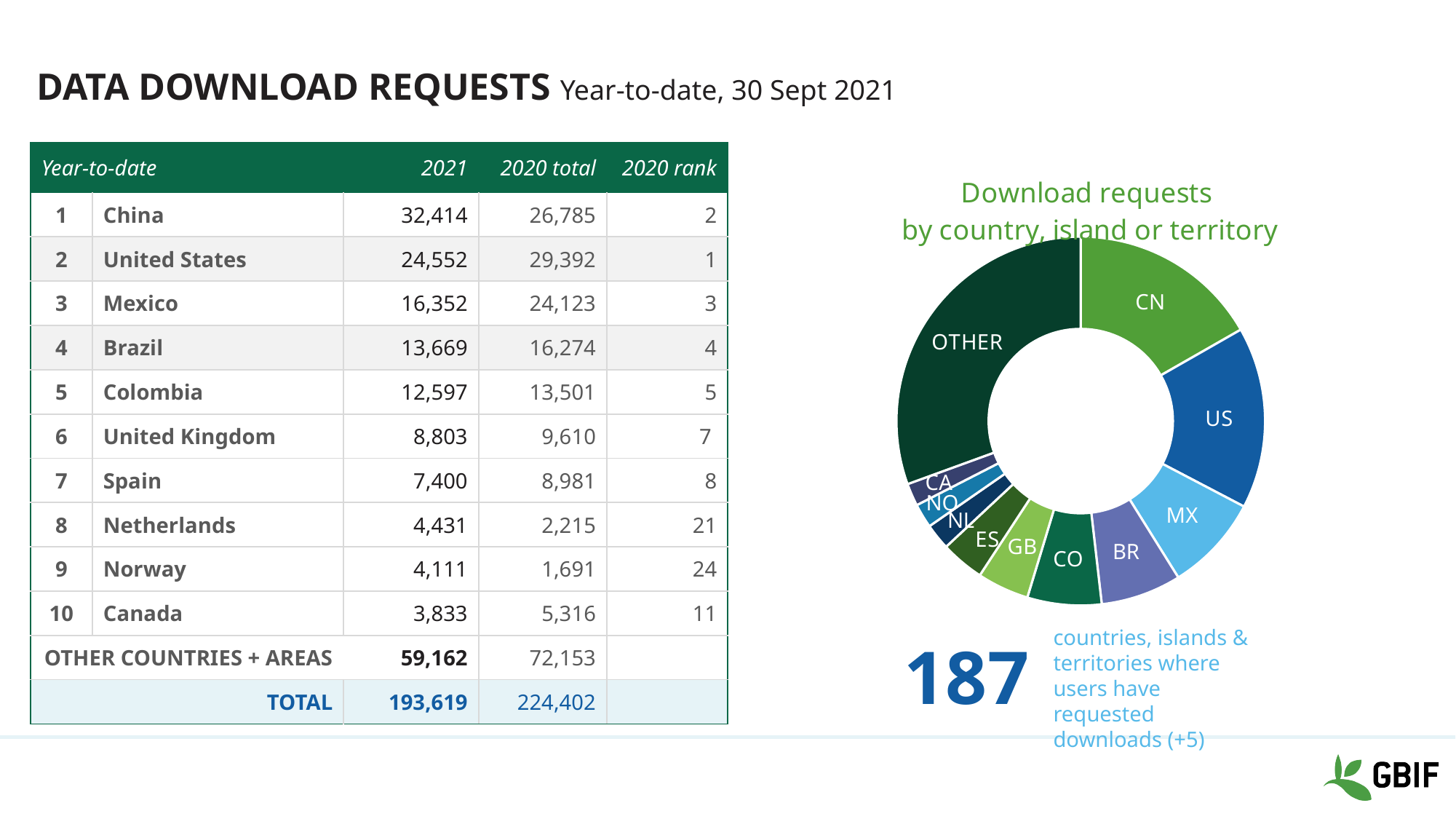
According to the slide, how many download requests in 2021 year-to-date does the CN slice represent? 32,414 Which country slice in the donut chart is the largest single country? CN What is the total number of download requests for 2021 year-to-date shown on the slide? 193,619 What is the title of the chart on the right? Download requests by country, island or territory What is the difference between the 2021 year-to-date requests for the US slice and the MX slice? 8,200 How many slices are labelled in the donut chart? 11 According to the slide, how many download requests in 2021 year-to-date does the OTHER slice represent? 59,162 In the donut chart, which slice is larger, CO or GB? CO Which slice of the donut chart is the largest? OTHER What kind of chart is shown on the right of the slide? Donut (pie) chart In the donut chart, which slice is larger, BR or ES? BR In the donut chart, which slice is larger, US or MX? US